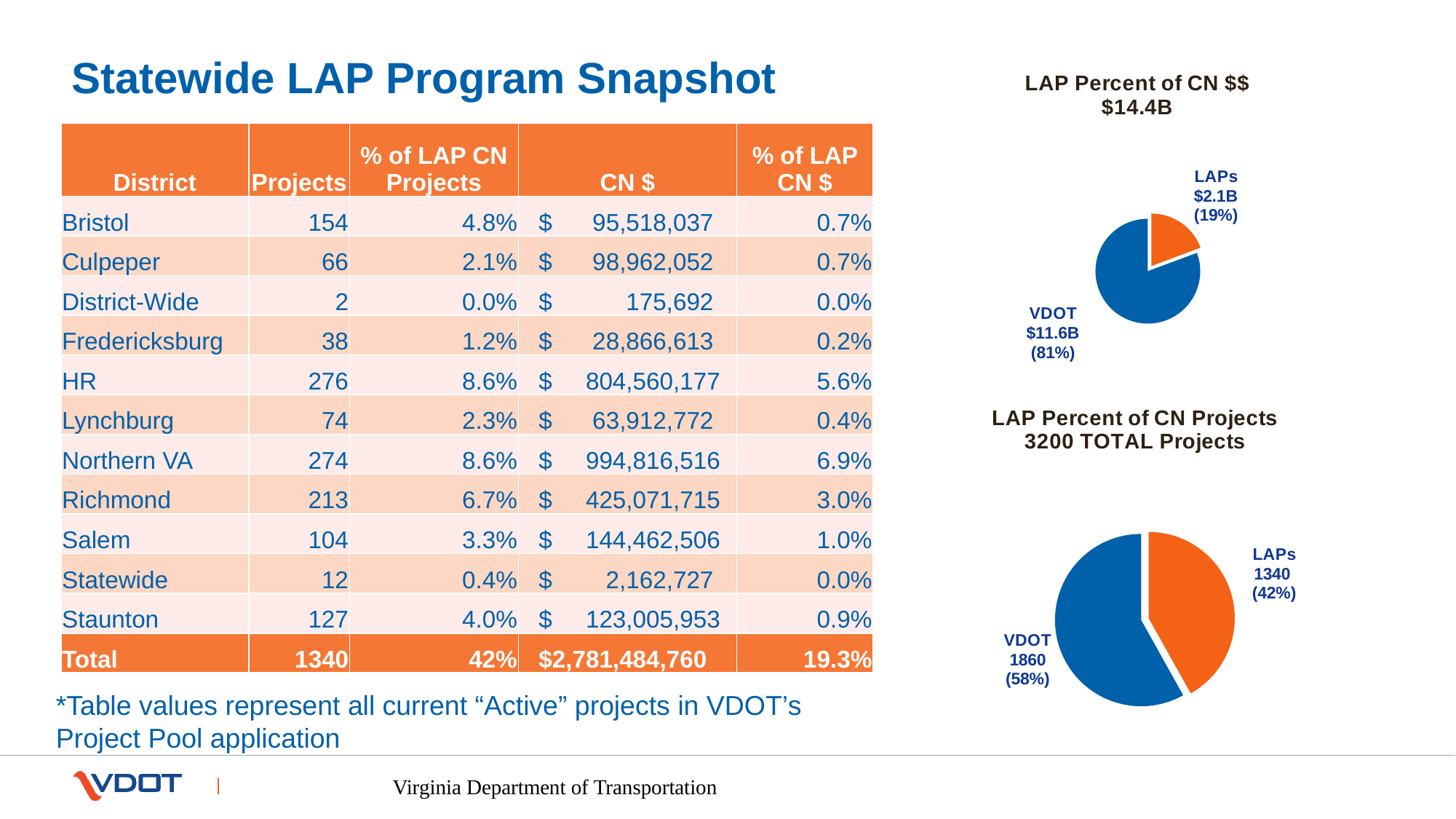
In the 'LAP Percent of CN Projects' pie chart, what is the difference in project count between VDOT and LAPs? 520 In the 'LAP Percent of CN Projects' pie chart, how many projects are shown for VDOT? 1860 In the 'LAP Percent of CN $$' pie chart, what is the value shown for LAPs? $2.1B How many slices does the 'LAP Percent of CN $$' pie chart have? 2 In the 'LAP Percent of CN Projects' pie chart, what share of the pie does the VDOT slice represent? 58% In the 'LAP Percent of CN Projects' pie chart, which slice is the smallest? LAPs In the 'LAP Percent of CN $$' pie chart, which slice is larger, LAPs or VDOT? VDOT What type of chart is used for 'LAP Percent of CN Projects'? Pie chart In the 'LAP Percent of CN Projects' pie chart, how many projects are shown for LAPs? 1340 In the 'LAP Percent of CN $$' pie chart, what is the value shown for VDOT? $11.6B What total is stated in the title of the 'LAP Percent of CN Projects' chart? 3200 TOTAL Projects In the 'LAP Percent of CN $$' pie chart, what share of the pie does the LAPs slice represent? 19%